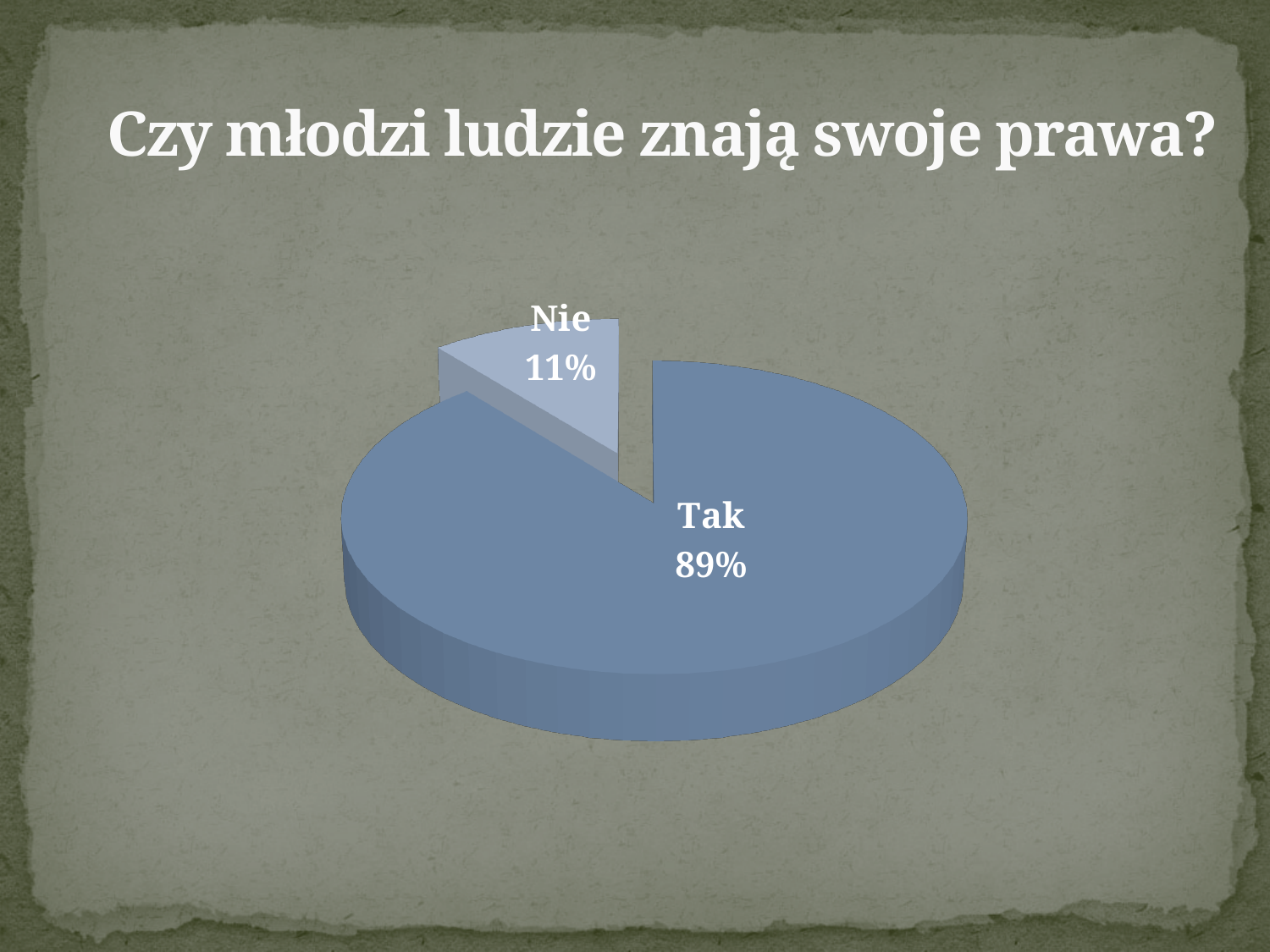
What is the title of the slide above the pie chart? Czy młodzi ludzie znają swoje prawa? Which slice is pulled out (exploded) from the pie? Nie How many slices does the pie chart have? 2 Which is larger, the "Tak" slice or the "Nie" slice? Tak Which slice of the pie is the smallest? Nie What percentage of the pie is labelled "Tak"? 89% What share of the pie does the "Nie" slice represent? 11% What percentage of the pie is labelled "Nie"? 11% What is the difference in percentage points between the "Tak" and "Nie" slices? 78 Which slice of the pie is the largest? Tak What kind of chart is shown on the slide? pie chart